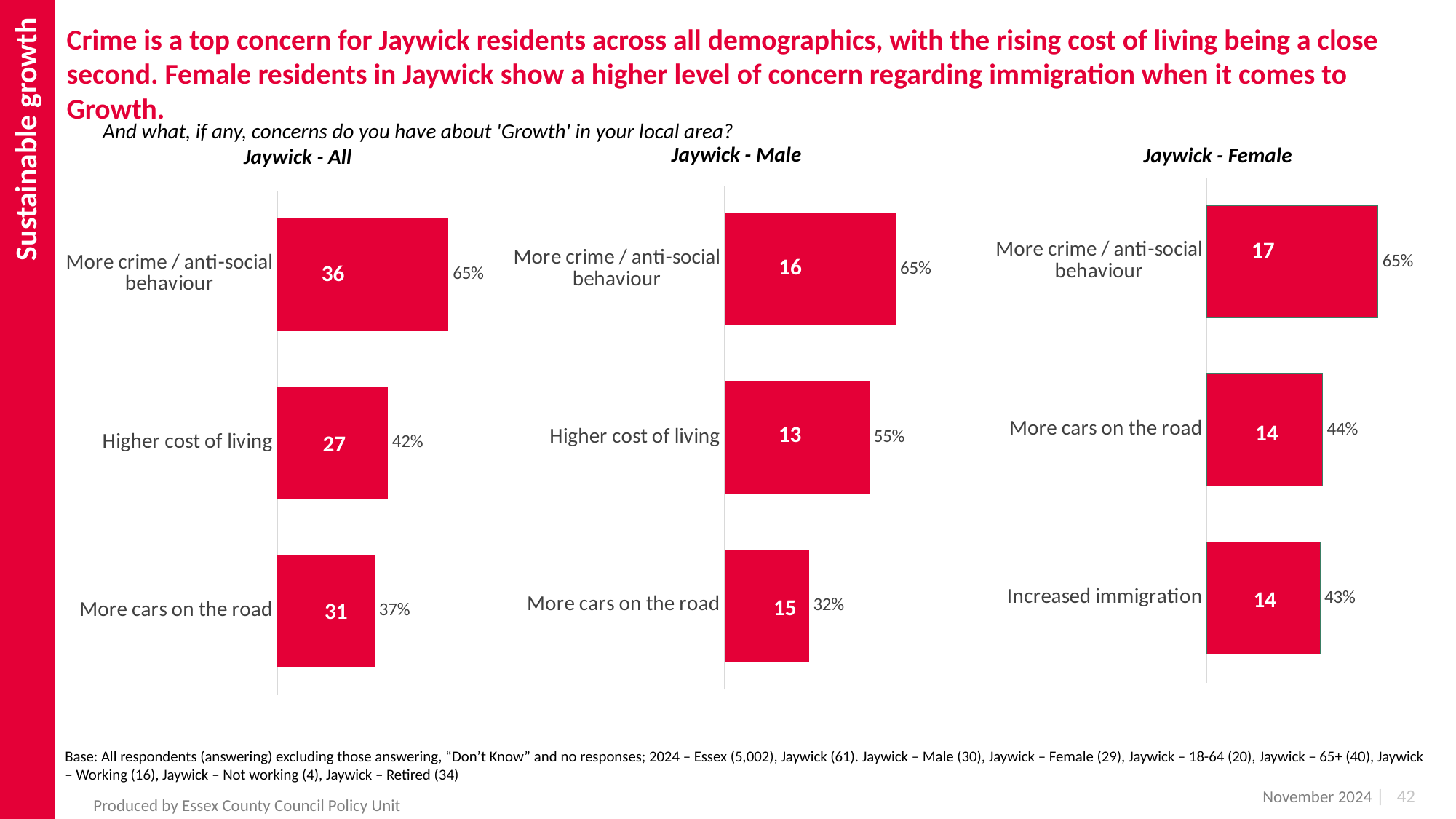
In the Jaywick - Male chart, which has the larger percentage: 'Higher cost of living' or 'More cars on the road'? Higher cost of living In the Jaywick - Male chart, which category has the highest percentage? More crime / anti-social behaviour In the Jaywick - All chart, what number is printed inside the bar for 'Higher cost of living'? 27 What is the title of the chart on the right of the slide? Jaywick - Female In the Jaywick - All chart, which category has the lowest percentage? More cars on the road How many categories are shown in the Jaywick - Female chart? 3 In the Jaywick - All chart, what is the difference in percentage points between 'More crime / anti-social behaviour' and 'Higher cost of living'? 23 What type of chart is the Jaywick - All chart? Bar chart In the Jaywick - All chart, what percentage is shown for 'More crime / anti-social behaviour'? 65% In the Jaywick - Female chart, what percentage is shown for 'Increased immigration'? 43% In the Jaywick - Female chart, what number is printed inside the bar for 'More cars on the road'? 14 In the Jaywick - Male chart, what percentage is shown for 'Higher cost of living'? 55%